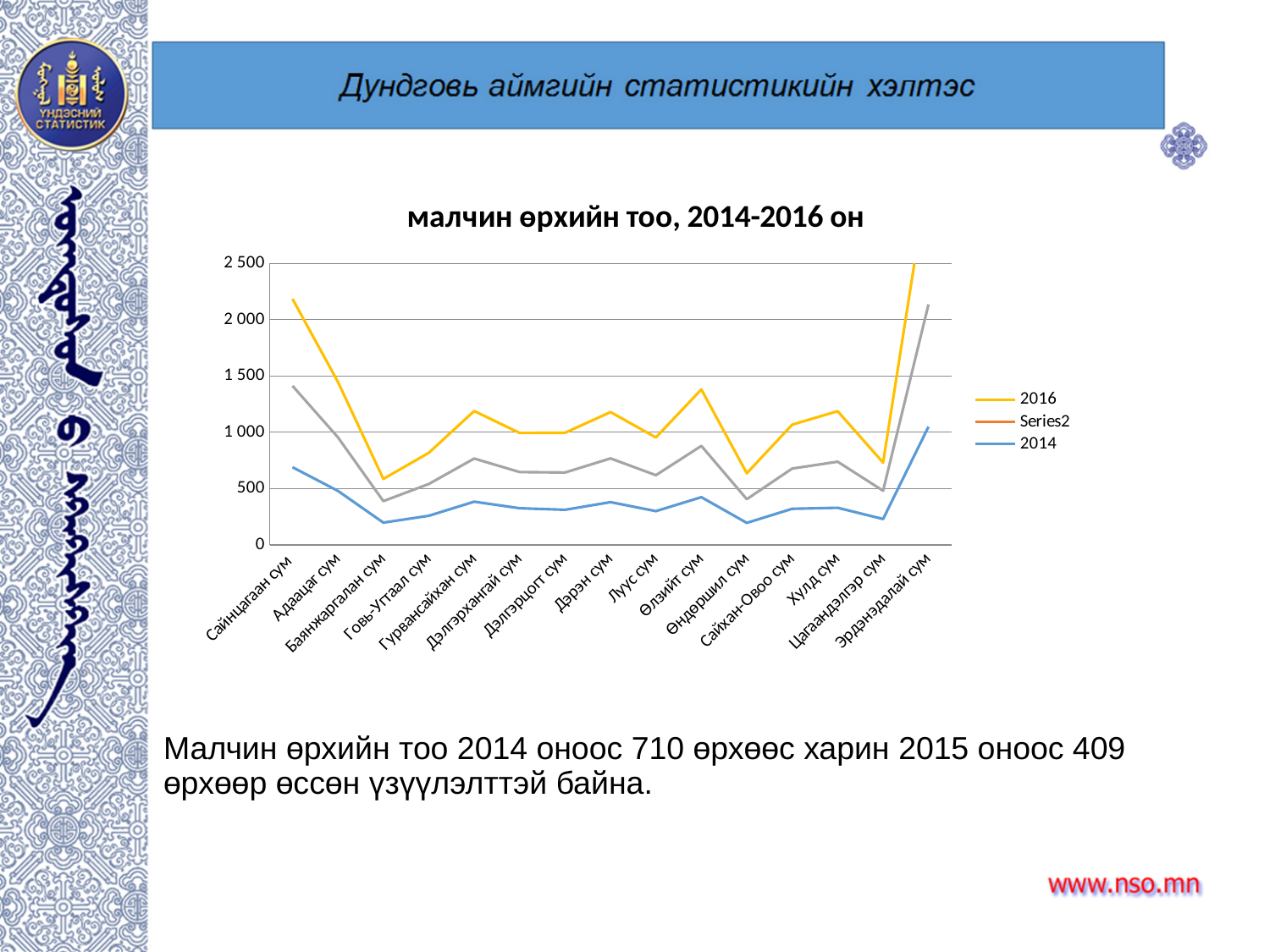
Does the 2016 line rise or fall from Сайнцагаан сум to Баянжаргалан сум? fall Is the 2014 value for Сайнцагаан сум greater or less than 500? greater How many series does the legend list? 3 What is the title of the chart? малчин өрхийн тоо, 2014-2016 он Is the 2016 value for Баянжаргалан сум greater or less than 1 000? less What kind of chart is shown on the slide? line chart Is the 2014 value for Баянжаргалан сум greater or less than 500? less For the 2014 series, which is larger: Эрдэнэдалай сум or Сайнцагаан сум? Эрдэнэдалай сум For the 2016 series, which is larger: Сайнцагаан сум or Адаацаг сум? Сайнцагаан сум How many sums (categories) are shown along the x axis? 15 Which sum has the highest value for the 2016 series? Эрдэнэдалай сум